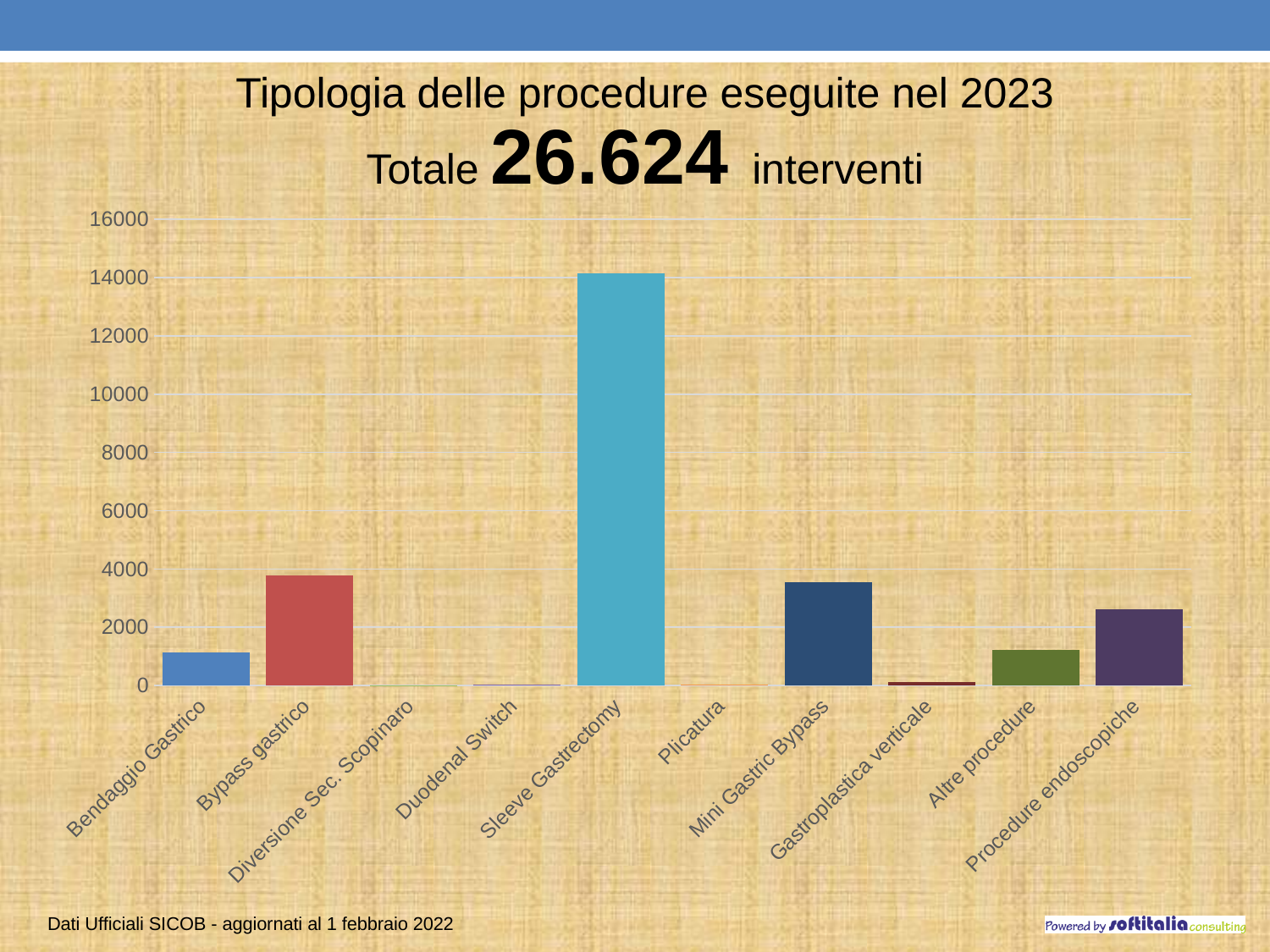
Is the value for Bypass gastrico greater or less than 2000? greater What total number of interventions is stated in the chart title? 26.624 Is the value for Procedure endoscopiche greater or less than 2000? greater Which is larger, the value for Procedure endoscopiche or the value for Altre procedure? Procedure endoscopiche Is the value for Sleeve Gastrectomy greater or less than 12000? greater What kind of chart is shown on the slide? bar chart Which procedure has the highest bar? Sleeve Gastrectomy Which is larger, the value for Sleeve Gastrectomy or the value for Bypass gastrico? Sleeve Gastrectomy How many procedure categories are shown on the x axis? 10 What is the title of the chart? Tipologia delle procedure eseguite nel 2023